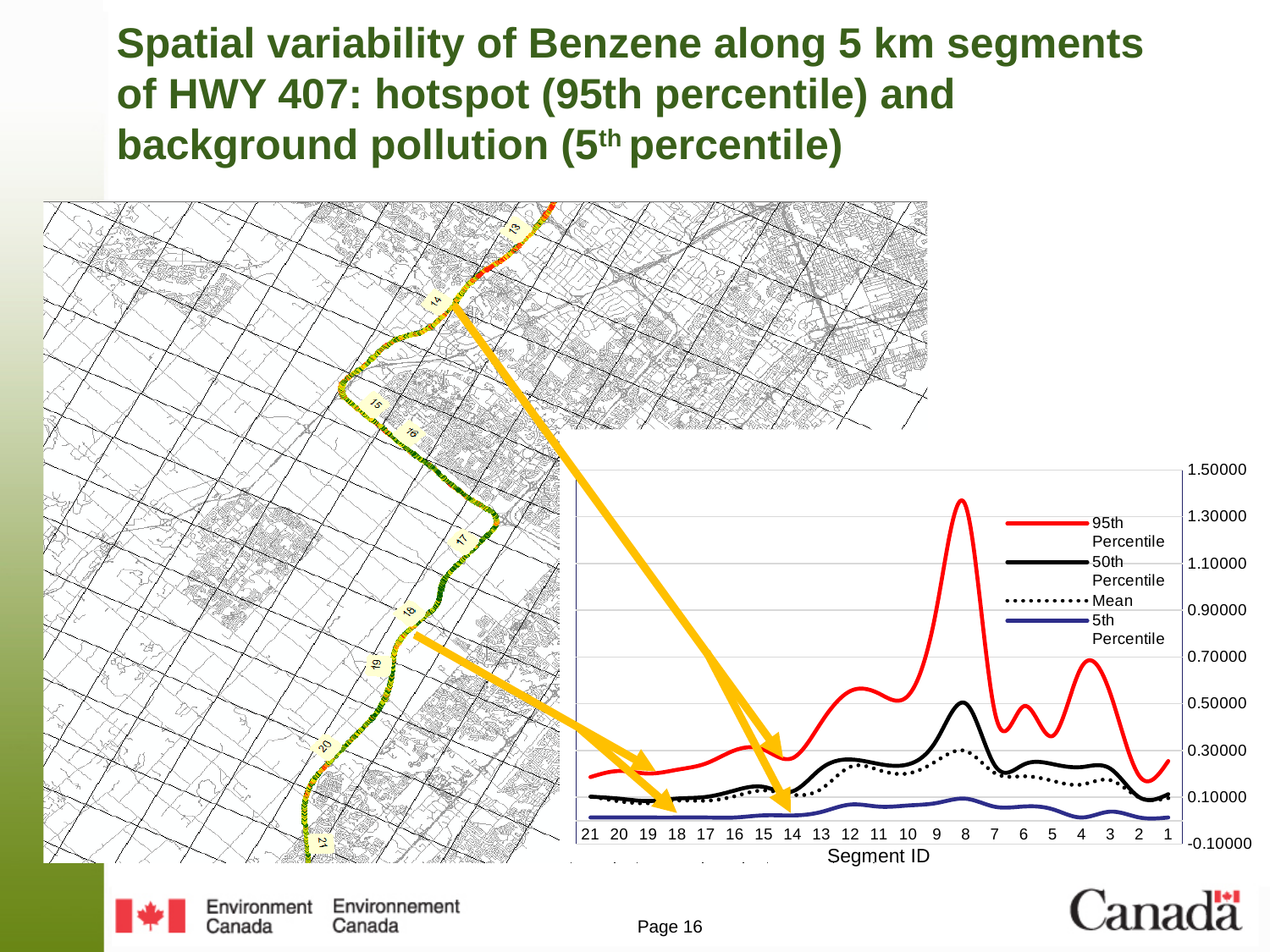
Is the 50th Percentile value at segment 8 greater or less than 0.30000? greater How many series does the chart legend list? 4 What is the title of the x axis of the chart? Segment ID Is the 5th Percentile value at segment 8 greater or less than 0.30000? less Which is larger for the 95th Percentile series: the value at segment 8 or the value at segment 4? segment 8 Which series has the lowest values across the segments? 5th Percentile At which segment ID does the 95th Percentile series reach its highest value? 8 What kind of chart is shown on the slide? line chart Is the 95th Percentile value at segment 21 greater or less than 0.30000? less Does the 95th Percentile series rise or fall from segment 9 to segment 8? rise How many segment IDs are shown along the x axis of the chart? 21